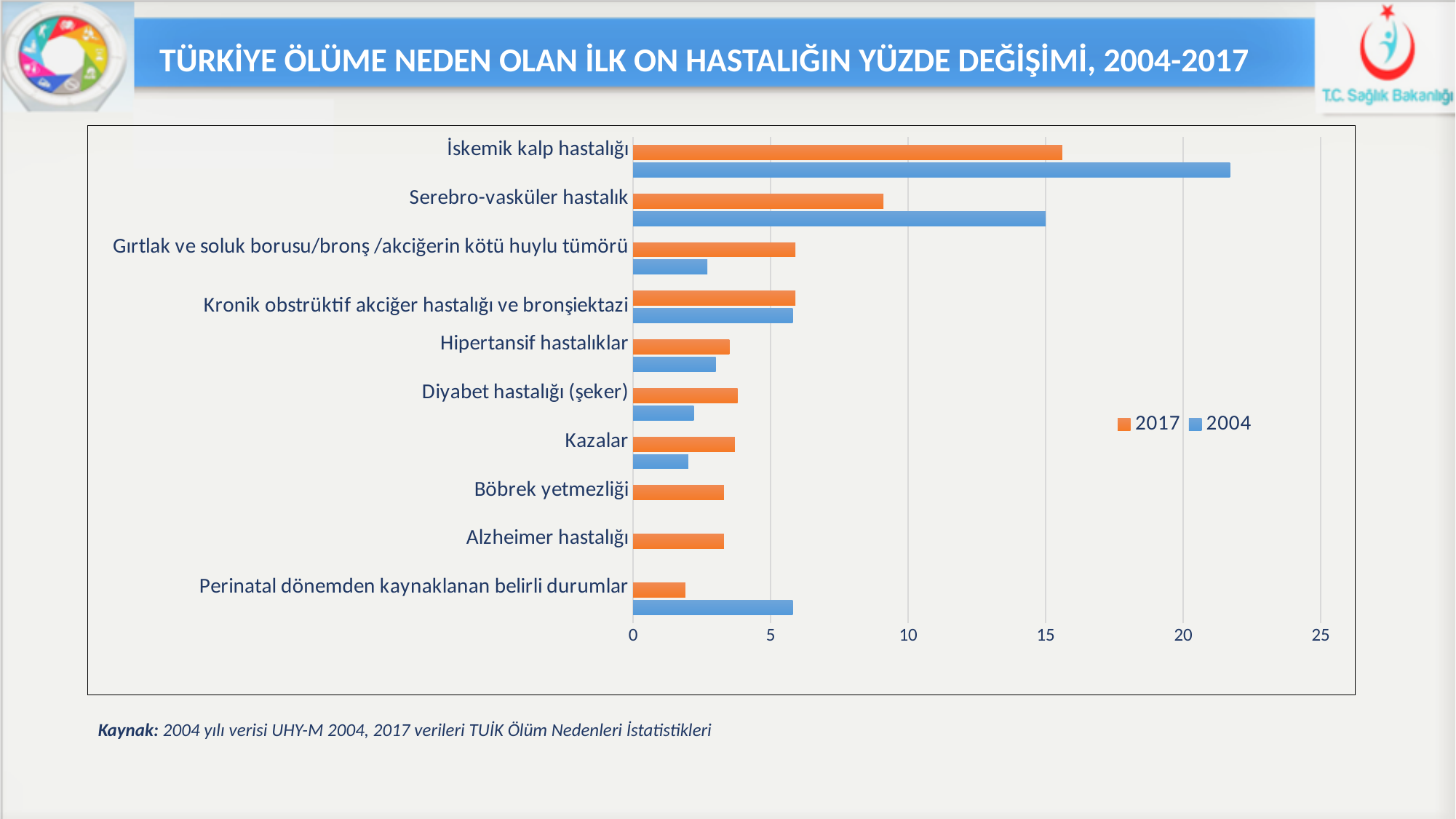
Which category has the highest value for 2004? İskemik kalp hastalığı For Perinatal dönemden kaynaklanan belirli durumlar, which year has the larger value, 2004 or 2017? 2004 How many disease categories are shown on the chart? 10 Which category has the highest value for 2017? İskemik kalp hastalığı What kind of chart is shown on the slide? bar chart Which category has the lowest 2017 value? Perinatal dönemden kaynaklanan belirli durumlar How many series does the legend list? 2 For Gırtlak ve soluk borusu/bronş /akciğerin kötü huylu tümörü, which year has the larger value, 2004 or 2017? 2017 Is the 2017 value for Serebro-vasküler hastalık greater or less than 10? less Which colour represents the 2017 series in the legend? orange Is the 2004 value for İskemik kalp hastalığı greater or less than 20? greater Is the 2017 value for İskemik kalp hastalığı greater or less than 15? greater